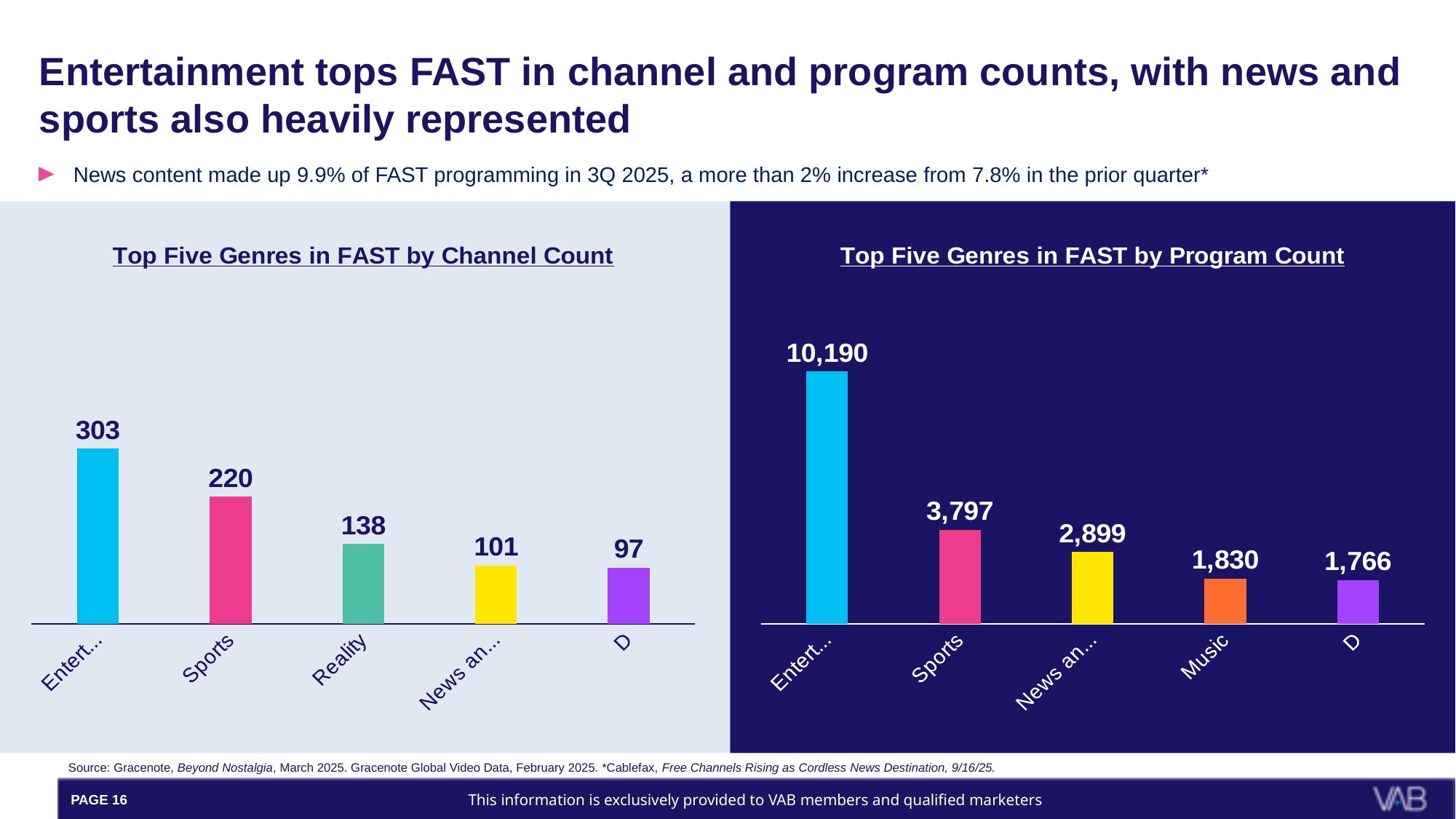
In the 'Top Five Genres in FAST by Program Count' chart, what is the value for Sports? 3,797 In the 'Top Five Genres in FAST by Program Count' chart, what is the difference between the Sports and Music values? 1,967 What kind of chart is 'Top Five Genres in FAST by Channel Count'? Bar chart In the 'Top Five Genres in FAST by Channel Count' chart, what is the value of the shortest bar? 97 In the 'Top Five Genres in FAST by Channel Count' chart, which is larger, Sports or Reality? Sports In the 'Top Five Genres in FAST by Program Count' chart, what is the value for Music? 1,830 In the 'Top Five Genres in FAST by Channel Count' chart, what is the value for Sports? 220 In the 'Top Five Genres in FAST by Program Count' chart, what is the value of the tallest bar? 10,190 In the 'Top Five Genres in FAST by Channel Count' chart, what is the difference between the Sports and Reality values? 82 How many bars are in the 'Top Five Genres in FAST by Program Count' chart? 5 In the 'Top Five Genres in FAST by Channel Count' chart, what is the value of the tallest bar? 303 In the 'Top Five Genres in FAST by Channel Count' chart, what is the value for Reality? 138